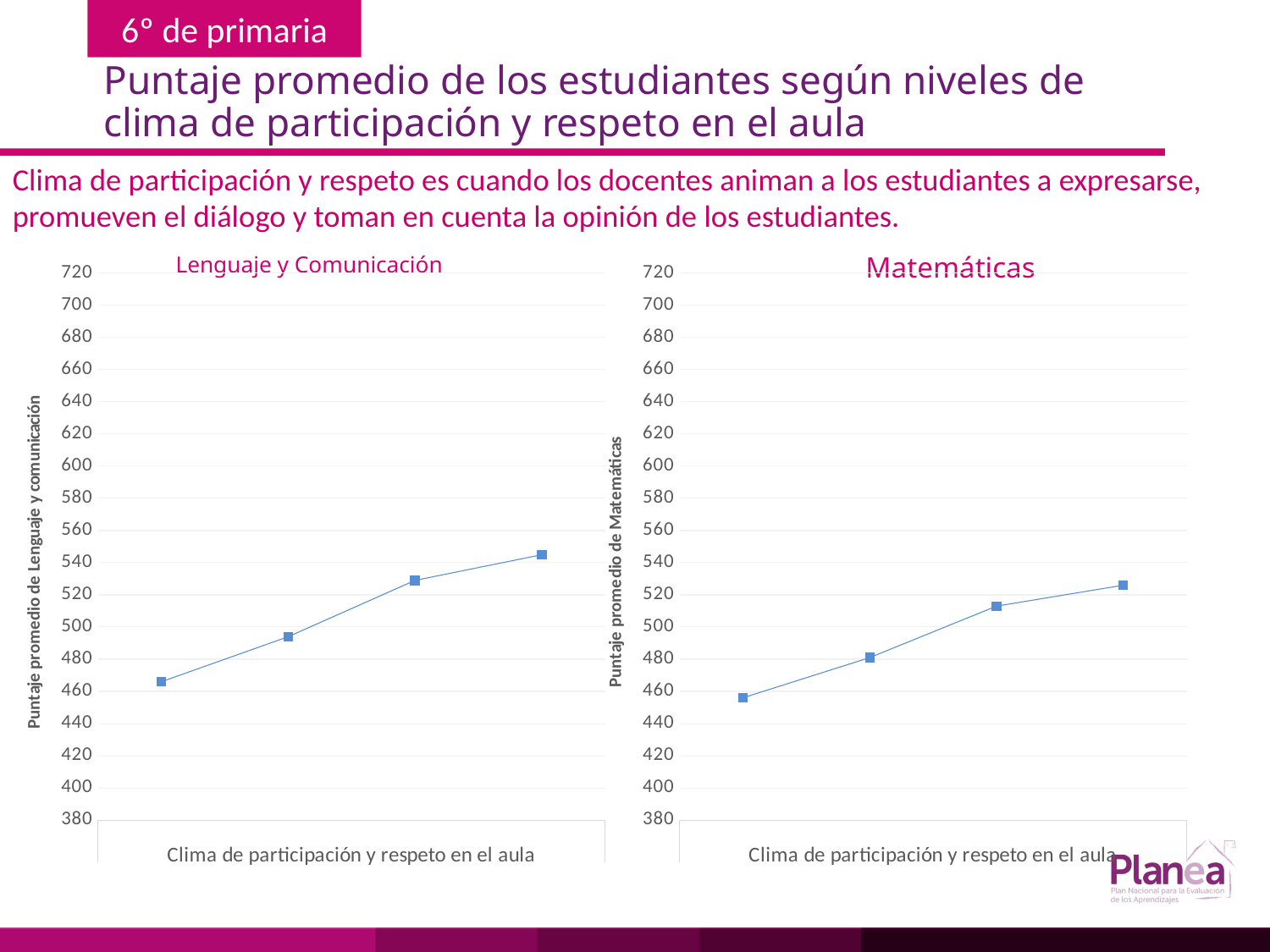
In the 'Matemáticas' chart, do the values rise or fall from left to right along the x axis? rise What kind of chart is the 'Lenguaje y Comunicación' chart? line chart How many data points are plotted in the 'Lenguaje y Comunicación' chart? 4 In the 'Lenguaje y Comunicación' chart, is the value of the rightmost point greater or less than 520? greater Which chart reaches a higher maximum value, 'Lenguaje y Comunicación' or 'Matemáticas'? Lenguaje y Comunicación In the 'Matemáticas' chart, is the value of the leftmost point greater or less than 480? less In the 'Lenguaje y Comunicación' chart, do the values rise or fall from left to right along the x axis? rise What kind of chart is the 'Matemáticas' chart? line chart What is the x-axis title of the 'Matemáticas' chart? Clima de participación y respeto en el aula How many data points are plotted in the 'Matemáticas' chart? 4 In the 'Matemáticas' chart, is the value of the rightmost point greater or less than 500? greater